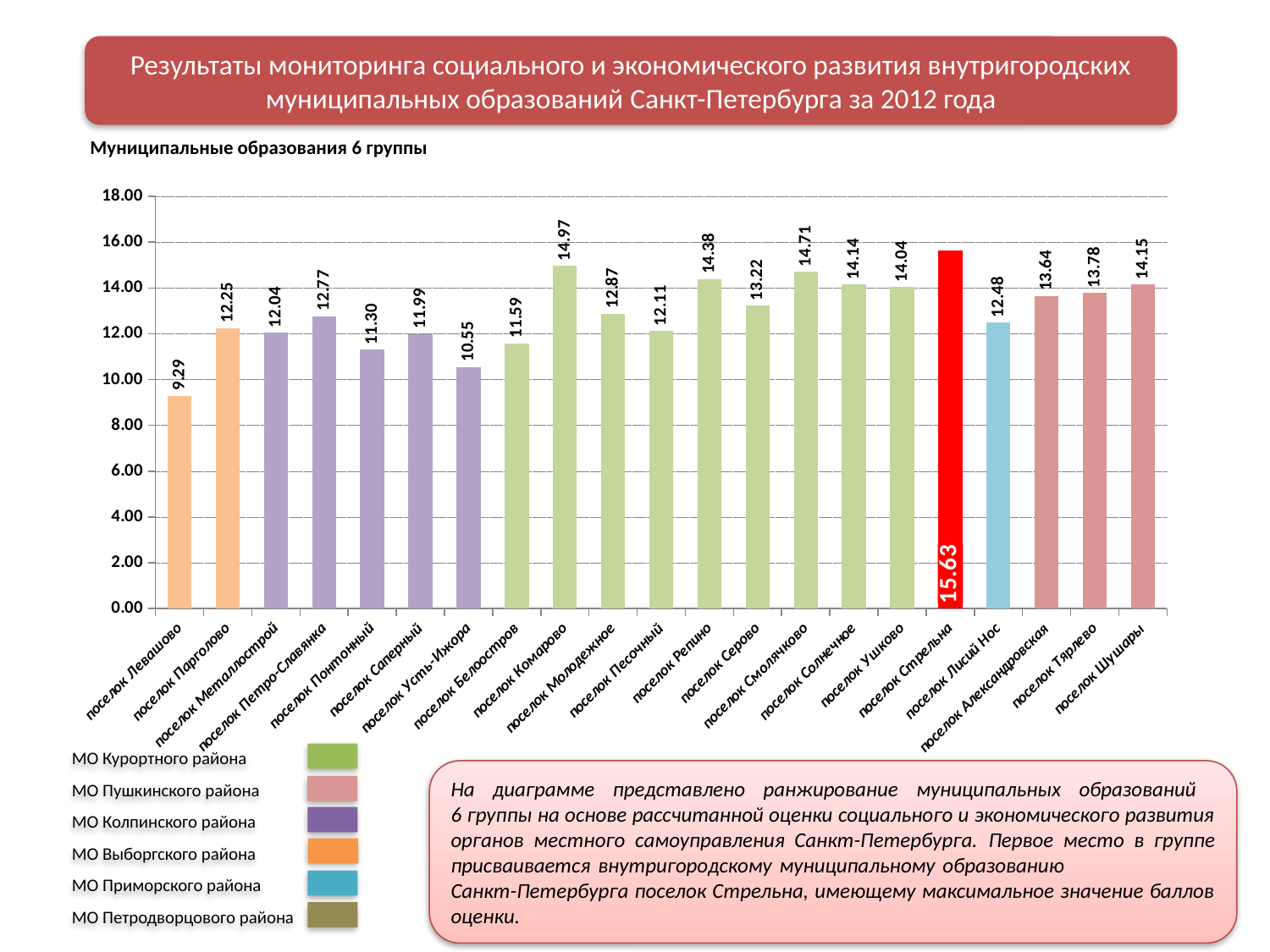
What is the difference between the values for поселок Стрельна and поселок Левашово? 6.34 Which has a larger value, поселок Шушары or поселок Тярлево? поселок Шушары What is the value for поселок Стрельна? 15.63 What kind of chart is shown on the slide? bar chart How many entries does the legend below the chart list? 6 What is the difference between the values for поселок Комарово and поселок Репино? 0.59 Is the value for поселок Усть-Ижора greater or less than 12.00? less Which municipality has the lowest value on the chart? поселок Левашово Which municipality has the highest value on the chart? поселок Стрельна What is the value for поселок Лисий Нос? 12.48 What is the value for поселок Комарово? 14.97 How many municipalities are shown on the chart? 21